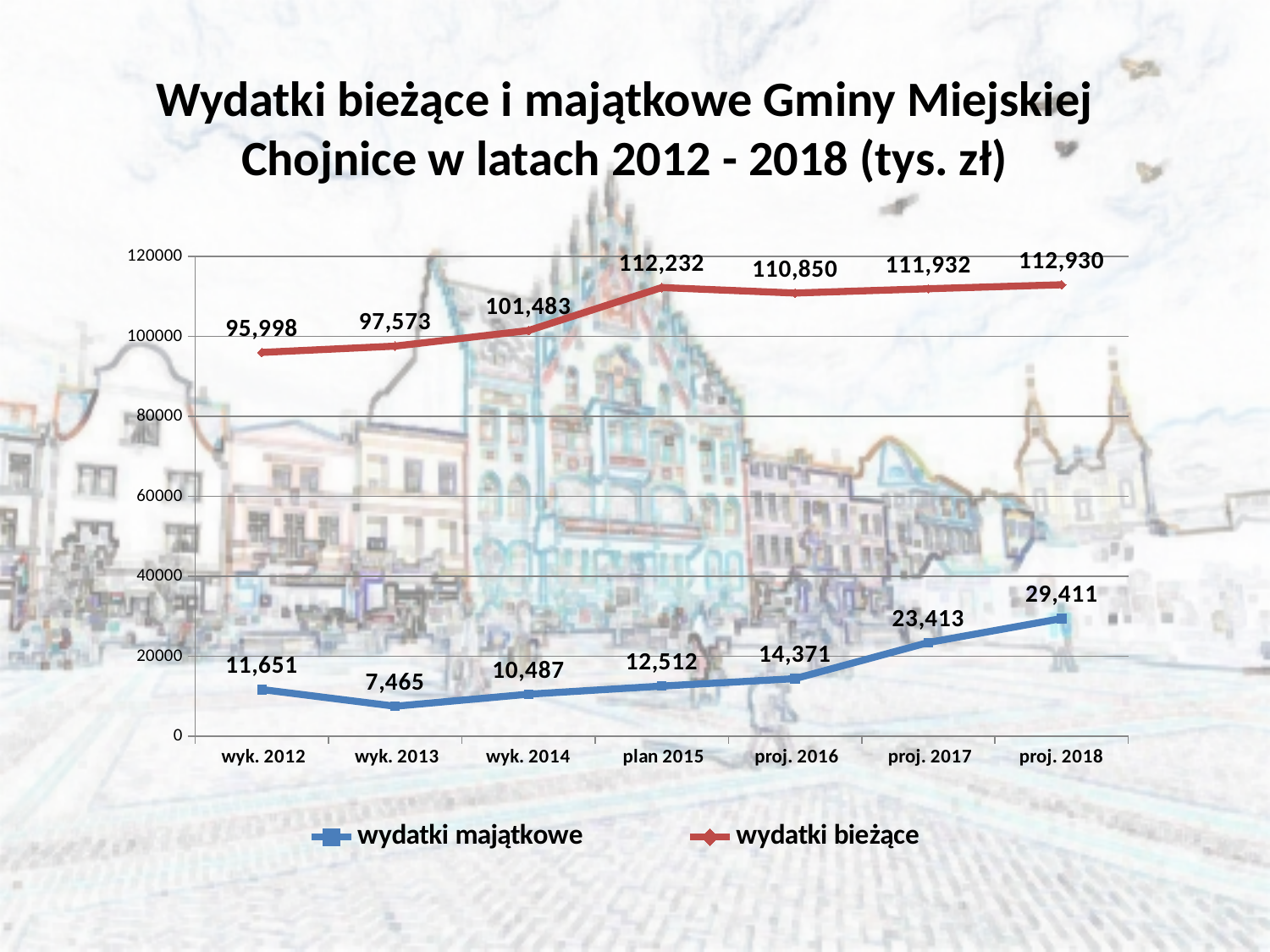
How many periods are shown on the x axis? 7 What type of chart is shown on the slide? line chart Which is larger: wydatki bieżące for plan 2015 or for proj. 2016? plan 2015 In which period is wydatki bieżące highest? proj. 2018 What is the difference between wydatki majątkowe for proj. 2018 and proj. 2017? 5,998 In which period is wydatki majątkowe lowest? wyk. 2013 Does wydatki majątkowe rise or fall from proj. 2016 to proj. 2018? rise What is the value of wydatki majątkowe for wyk. 2013? 7,465 How many series does the legend list? 2 What is the value of wydatki bieżące for plan 2015? 112,232 What is the value of wydatki majątkowe for proj. 2018? 29,411 Which colour is used for the wydatki bieżące series? red